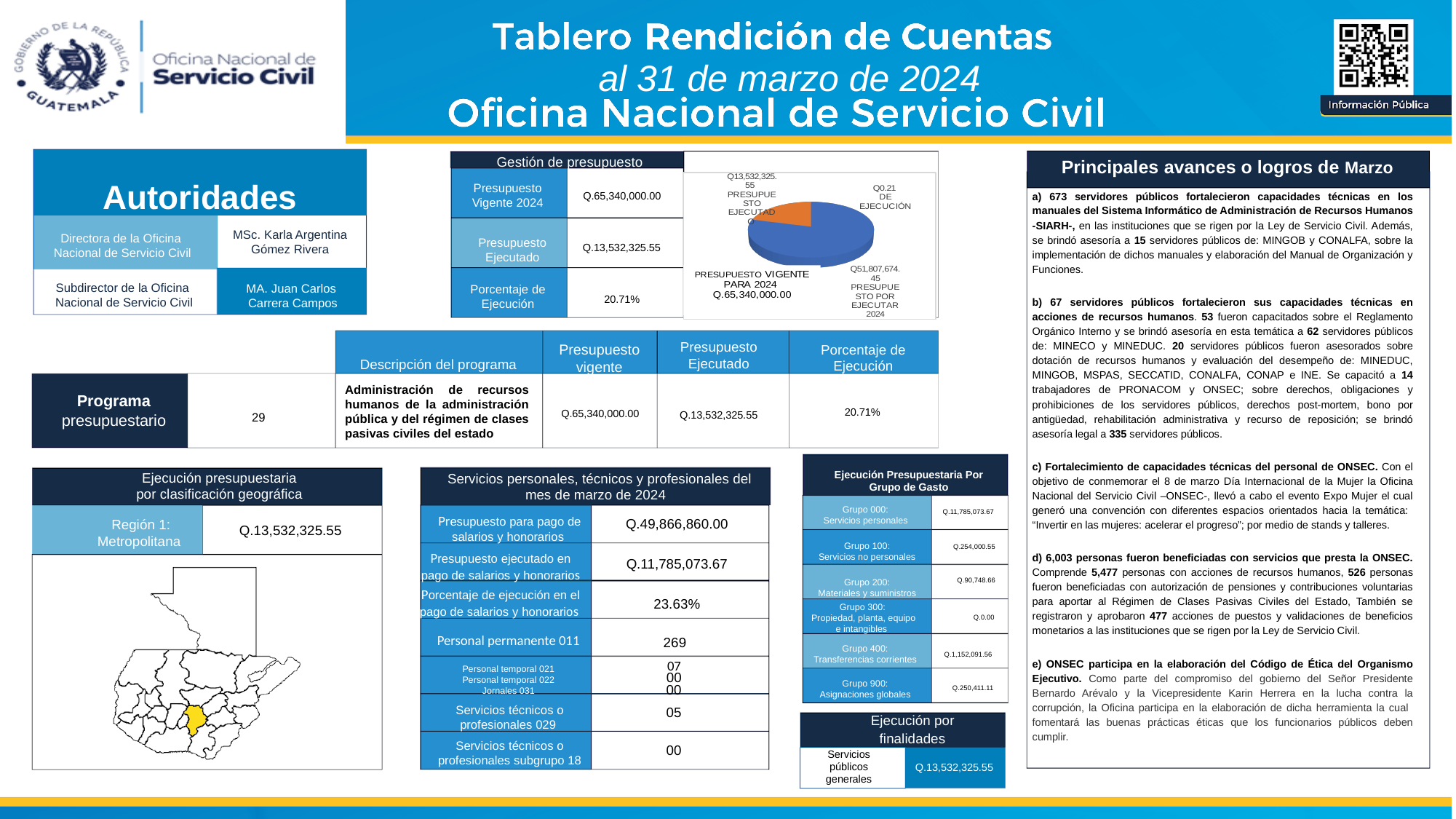
What is the difference between PRESUPUESTO POR EJECUTAR 2024 and PRESUPUESTO EJECUTADO in the pie chart? Q38,275,348.90 In the pie chart, which is larger: PRESUPUESTO EJECUTADO or PRESUPUESTO POR EJECUTAR 2024? PRESUPUESTO POR EJECUTAR 2024 In the pie chart, what value is shown for PRESUPUESTO EJECUTADO? Q13,532,325.55 What colour is the PRESUPUESTO EJECUTADO slice in the pie chart? orange What total is shown for PRESUPUESTO VIGENTE PARA 2024 next to the pie chart? Q.65,340,000.00 What kind of chart is shown in the Gestión de presupuesto section? pie chart What share of the total budget does the PRESUPUESTO EJECUTADO slice represent, according to the slide? 20.71% In the pie chart, what value is shown for PRESUPUESTO POR EJECUTAR 2024? Q51,807,674.45 Which slice of the pie chart is the largest? PRESUPUESTO POR EJECUTAR 2024 What colour is the PRESUPUESTO POR EJECUTAR 2024 slice in the pie chart? blue